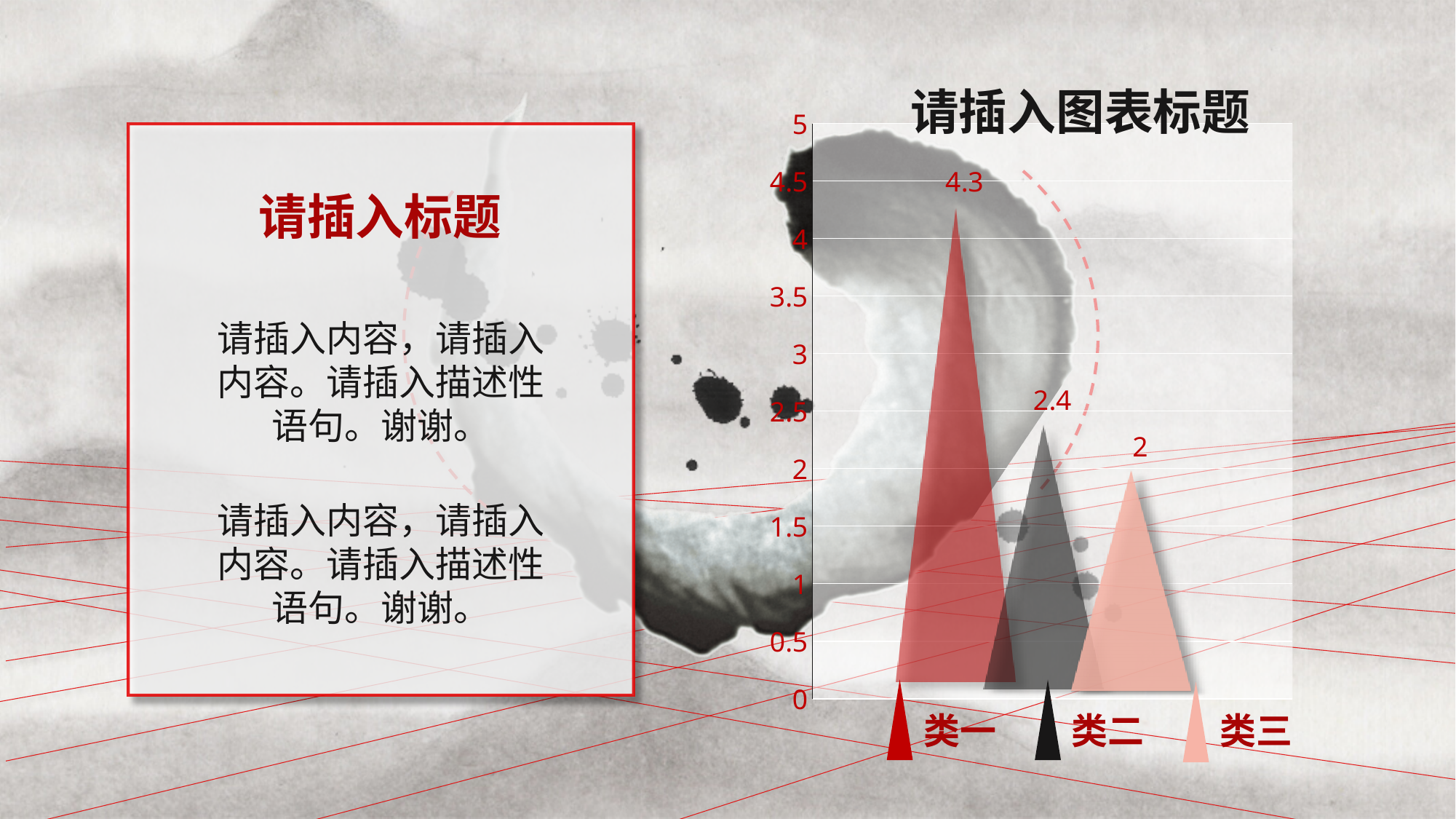
Which series has the highest value? 类一 What is the value shown for 类一? 4.3 What kind of chart is shown on the slide? bar chart What is the title of the chart? 请插入图表标题 How many series does the legend list? 3 What is the difference between the values for 类二 and 类三? 0.4 What is the value shown for 类三? 2 Is the value for 类一 greater or less than 4? greater Which is larger, the value for 类一 or the value for 类三? 类一 What is the difference between the values for 类一 and 类二? 1.9 What is the value shown for 类二? 2.4 Which series has the lowest value? 类三